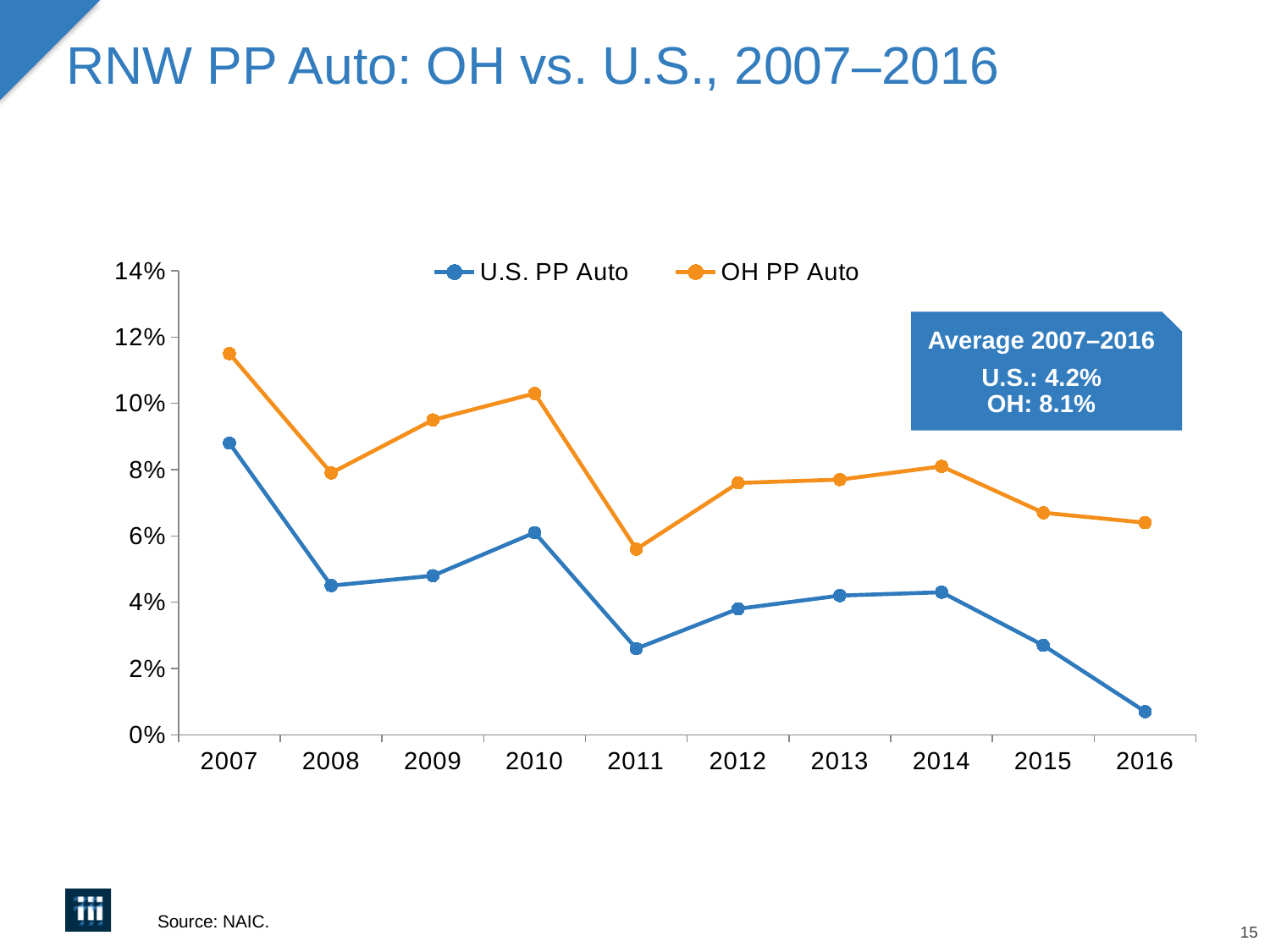
Is the U.S. PP Auto value for 2007 greater or less than 8%? greater According to the callout box, what is the OH average for 2007–2016? 8.1% How many years are plotted along the x axis? 10 In which year is the OH PP Auto value highest? 2007 In which year is the U.S. PP Auto value lowest? 2016 Which series has the higher value in 2013, U.S. PP Auto or OH PP Auto? OH PP Auto Is the U.S. PP Auto value for 2016 greater or less than 2%? less How many series does the legend list? 2 In which year is the OH PP Auto value lowest? 2011 Does the U.S. PP Auto line rise or fall from 2014 to 2016? Fall What type of chart is shown on the slide? Line chart Is the OH PP Auto value for 2007 greater or less than 10%? greater